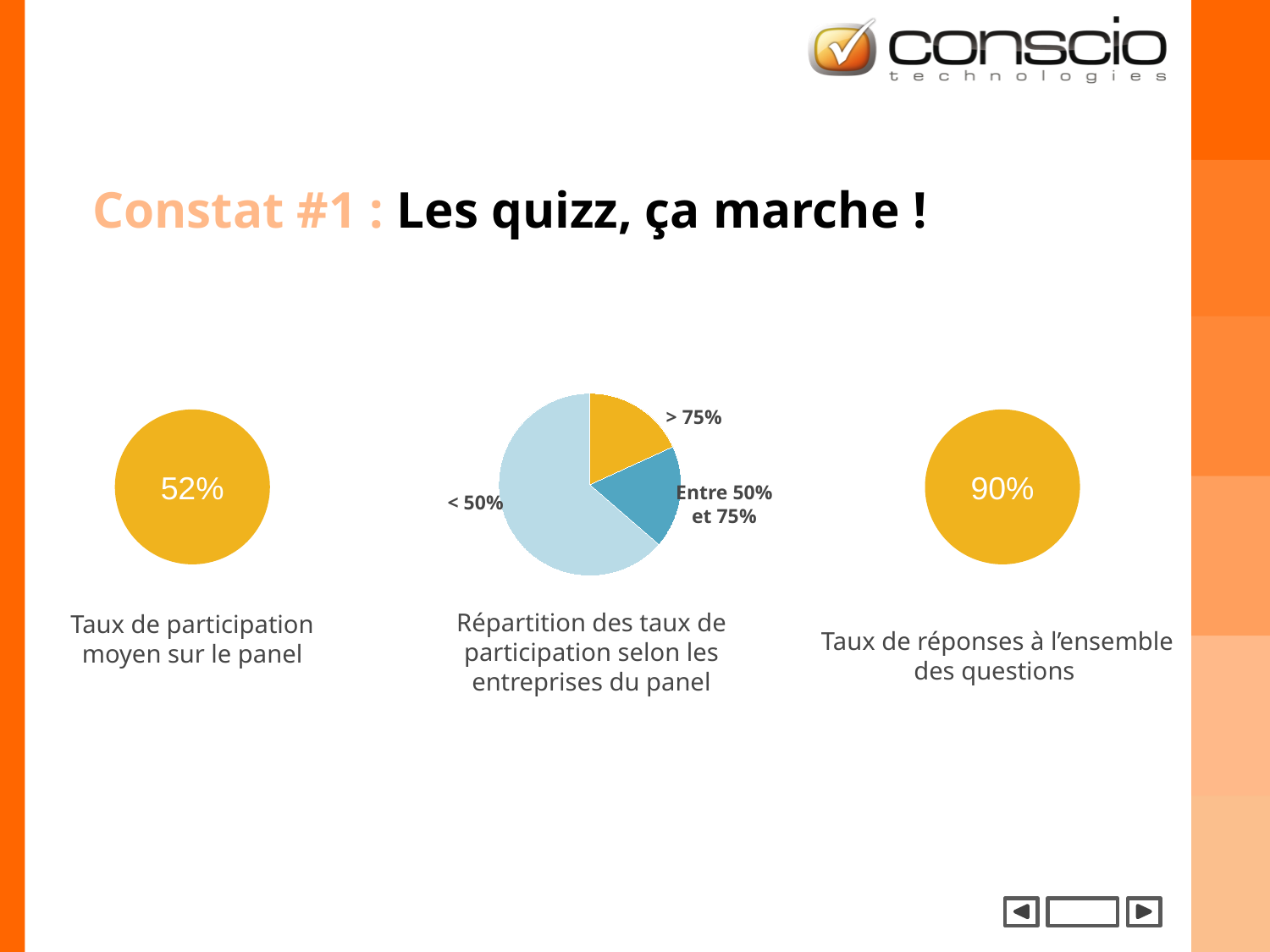
What colour is the '> 75%' slice in the pie chart 'Répartition des taux de participation selon les entreprises du panel'? yellow In the pie chart 'Répartition des taux de participation selon les entreprises du panel', which slice is larger: '< 50%' or '> 75%'? < 50% In the pie chart 'Répartition des taux de participation selon les entreprises du panel', which slice is larger: '< 50%' or 'Entre 50% et 75%'? < 50% How many slices does the pie chart 'Répartition des taux de participation selon les entreprises du panel' have? 3 In the pie chart 'Répartition des taux de participation selon les entreprises du panel', does the '< 50%' slice represent more or less than half of the pie? more What kind of chart is shown in the middle of the slide, under the caption 'Répartition des taux de participation selon les entreprises du panel'? pie chart What are the three category labels on the pie chart in the middle of the slide? > 75%, Entre 50% et 75%, < 50% In the pie chart 'Répartition des taux de participation selon les entreprises du panel', which category has the largest slice? < 50%